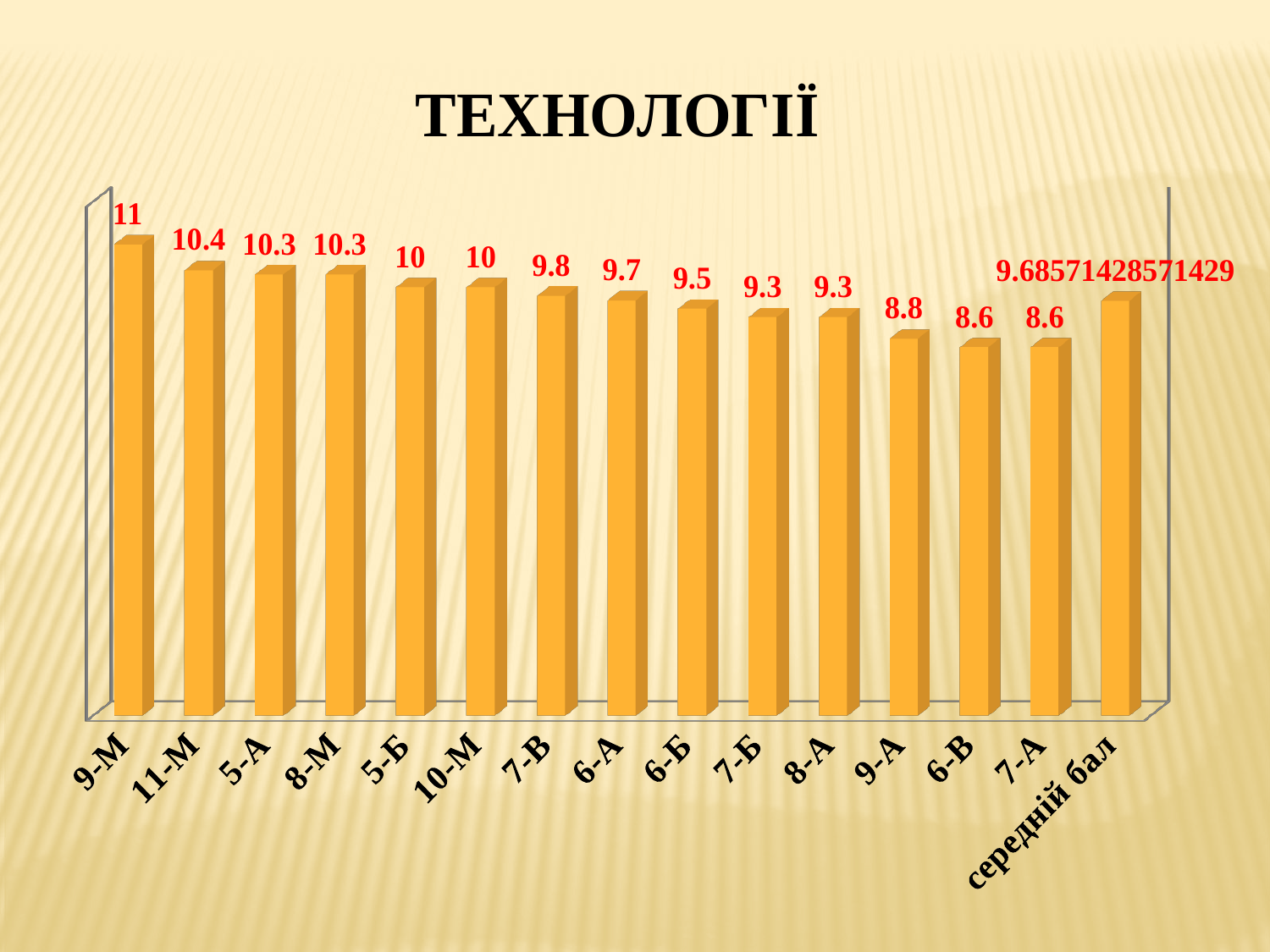
What is the title of the chart? ТЕХНОЛОГІЇ What is the value for 11-М? 10.4 What is the difference between the values for 11-М and 9-А? 1.6 What is the value for 9-М? 11 Which is larger, the value for 5-А or the value for 7-Б? 5-А Which is larger, the value for 9-А or the value for 10-М? 10-М What is the difference between the values for 9-М and 7-А? 2.4 What type of chart is shown on the slide? bar chart What is the value for 6-Б? 9.5 What is the value shown for середній бал? 9.68571428571429 Which category has the highest value? 9-М How many bars are shown in the chart? 15